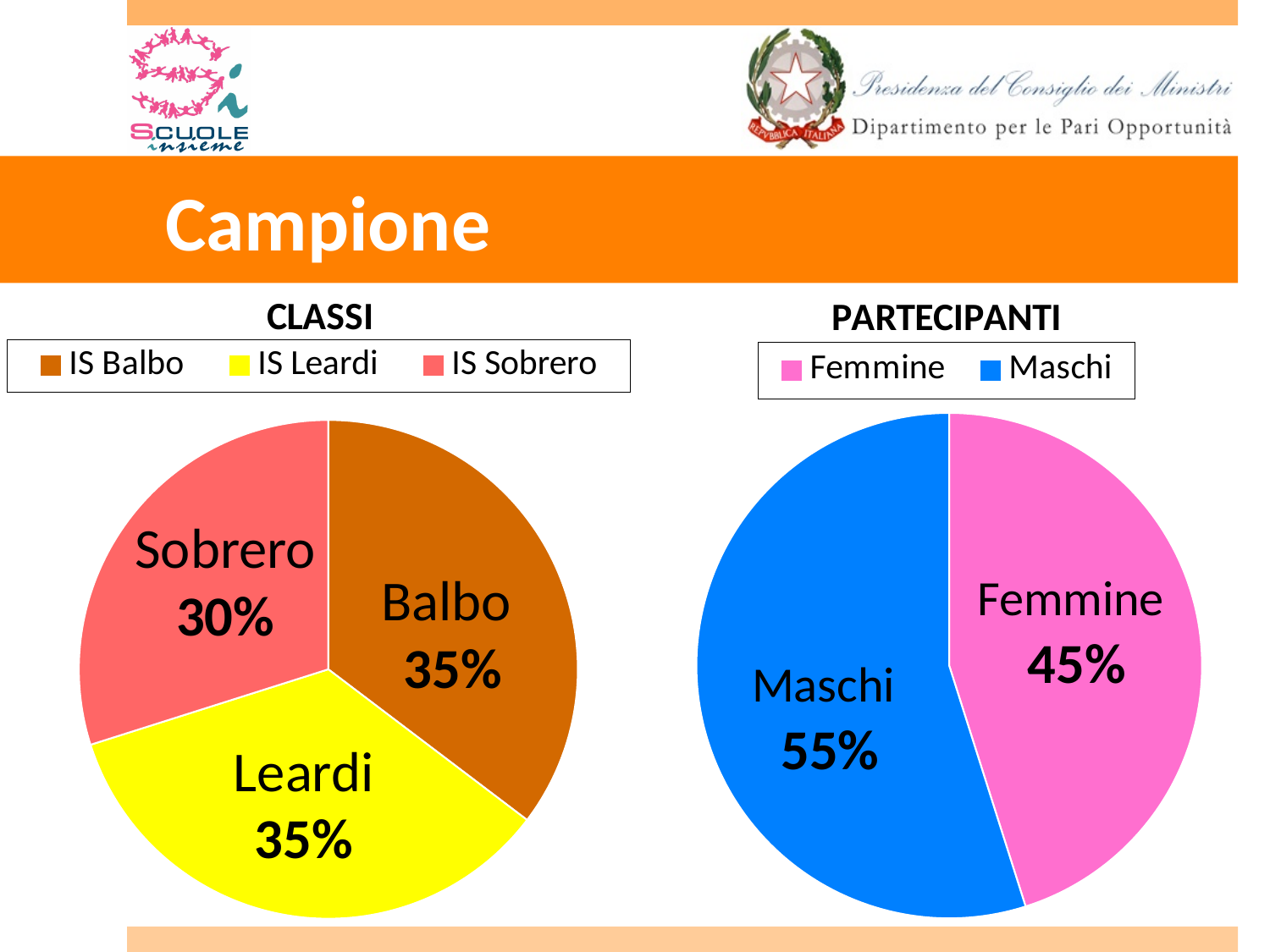
In the CLASSI chart, what share does Balbo have? 35% In the CLASSI chart, how many entries does the legend list? 3 In the PARTECIPANTI chart, what share do Femmine have? 45% In the CLASSI chart, what share does Sobrero have? 30% What kind of chart is the PARTECIPANTI chart? Pie chart In the CLASSI chart, what is the difference between the Balbo and Sobrero shares? 5% In the CLASSI chart, which slice is the smallest? Sobrero In the PARTECIPANTI chart, what share do Maschi have? 55% In the PARTECIPANTI chart, what is the difference between the Maschi and Femmine shares? 10% In the CLASSI chart, which colour represents IS Leardi? Yellow In the CLASSI chart, how many slices does the pie have? 3 In the PARTECIPANTI chart, which group has the larger share, Femmine or Maschi? Maschi